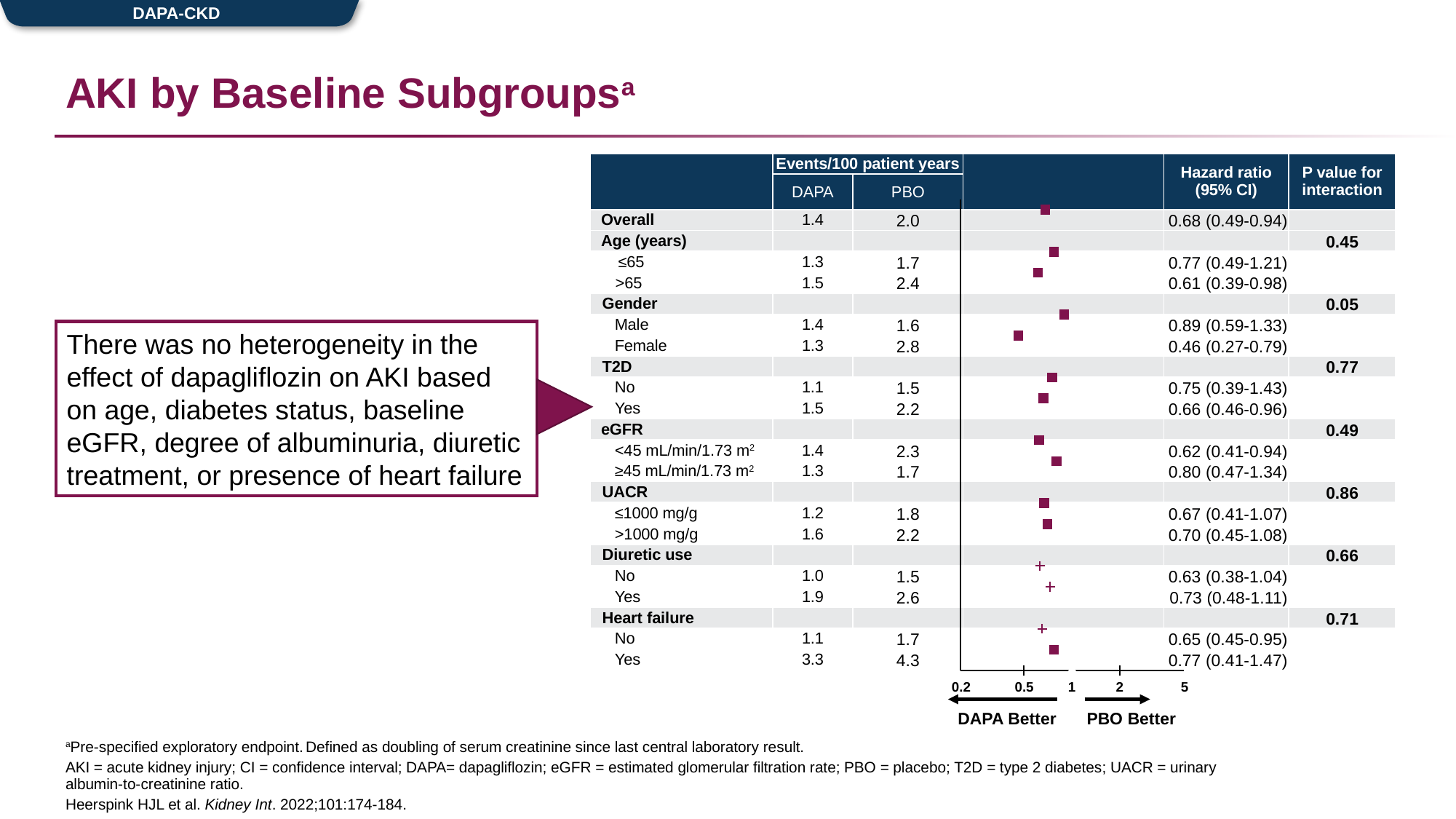
What is the DAPA event rate per 100 patient years for patients with heart failure (Yes)? 3.3 What is the hazard ratio (95% CI) for the Overall group? 0.68 (0.49-0.94) What kind of chart is shown on the slide? Forest plot Which subgroup has the highest hazard ratio? Male What is the difference between the PBO and DAPA event rates per 100 patient years for the Overall group? 0.6 Which has the larger hazard ratio: eGFR <45 mL/min/1.73 m2 or eGFR ≥45 mL/min/1.73 m2? ≥45 mL/min/1.73 m2 What label appears under the left arrow below the x axis of the forest plot? DAPA Better How many hazard ratio points are plotted in the forest plot, including Overall? 15 Is the hazard ratio for Male patients greater or less than 1? less What is the hazard ratio (95% CI) for Female patients? 0.46 (0.27-0.79) What is the P value for interaction for Gender? 0.05 Which subgroup has the lowest hazard ratio? Female